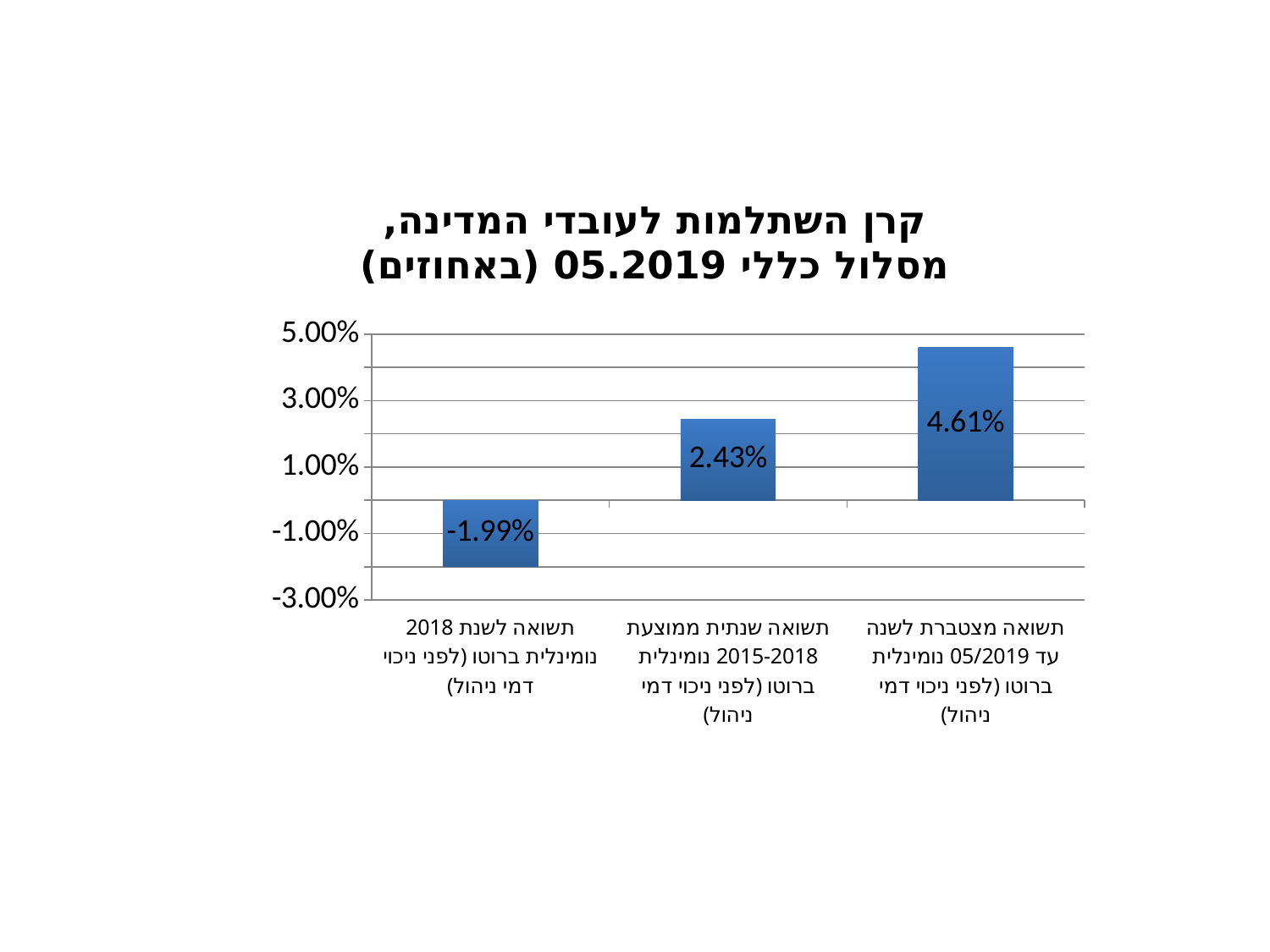
What kind of chart is shown on the slide? bar chart Which is larger: the value for "תשואה שנתית ממוצעת 2015-2018" or the value for "תשואה מצטברת לשנה עד 05/2019"? תשואה מצטברת לשנה עד 05/2019 What is the value for "תשואה לשנת 2018 נומינלית ברוטו (לפני ניכוי דמי ניהול)"? -1.99% Which category has the lowest value? תשואה לשנת 2018 נומינלית ברוטו (לפני ניכוי דמי ניהול) What is the value for "תשואה מצטברת לשנה עד 05/2019 נומינלית ברוטו (לפני ניכוי דמי ניהול)"? 4.61% Is the value for "תשואה מצטברת לשנה עד 05/2019" greater or less than 3.00%? greater How many categories are shown in the chart? 3 What is the title of the chart? קרן השתלמות לעובדי המדינה, מסלול כללי 05.2019 (באחוזים) What is the difference between the value for "תשואה שנתית ממוצעת 2015-2018" and the value for "תשואה לשנת 2018"? 4.42% What is the value for "תשואה שנתית ממוצעת 2015-2018 נומינלית ברוטו (לפני ניכוי דמי ניהול)"? 2.43% What is the difference between the value for "תשואה מצטברת לשנה עד 05/2019" and the value for "תשואה שנתית ממוצעת 2015-2018"? 2.18% Which category has the highest value? תשואה מצטברת לשנה עד 05/2019 נומינלית ברוטו (לפני ניכוי דמי ניהול)